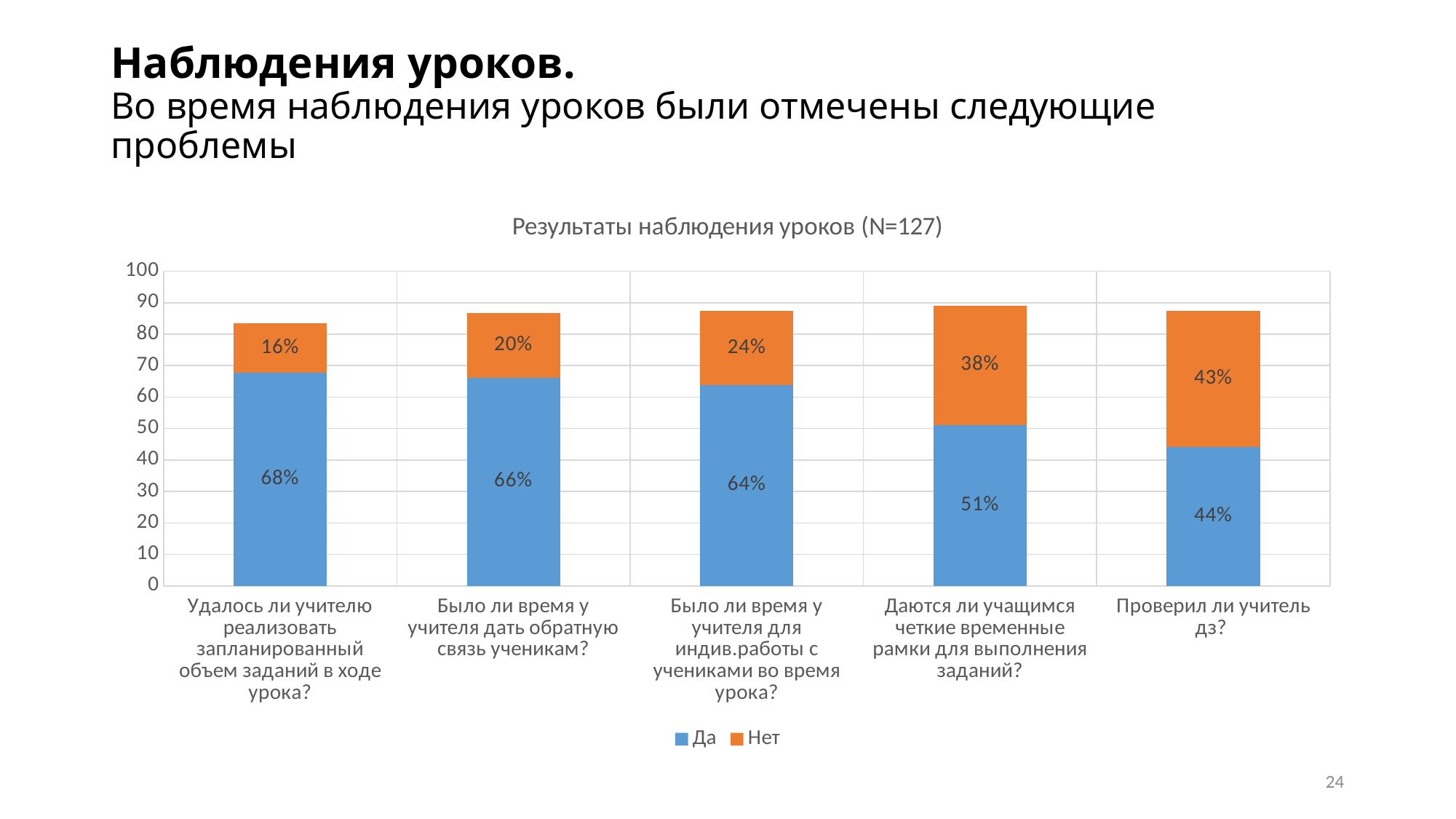
Which category has the lowest 'Нет' value? Удалось ли учителю реализовать запланированный объем заданий в ходе урока? What is the 'Да' value for 'Проверил ли учитель дз?' 44% What type of chart is shown on the slide? stacked bar chart What is the title of the chart? Результаты наблюдения уроков (N=127) What is the difference between the 'Да' and 'Нет' values for 'Было ли время у учителя для индив.работы с учениками во время урока?' 40% Which category has the highest 'Да' value? Удалось ли учителю реализовать запланированный объем заданий в ходе урока? What is the 'Нет' value for 'Даются ли учащимся четкие временные рамки для выполнения заданий?' 38% What is the total of the stacked bar for 'Удалось ли учителю реализовать запланированный объем заданий в ходе урока?' 84% How many categories (questions) are shown on the x axis? 5 How many series does the legend list? 2 Which is larger for 'Проверил ли учитель дз?': the 'Да' value or the 'Нет' value? Да What is the 'Да' value for 'Было ли время у учителя дать обратную связь ученикам?' 66%